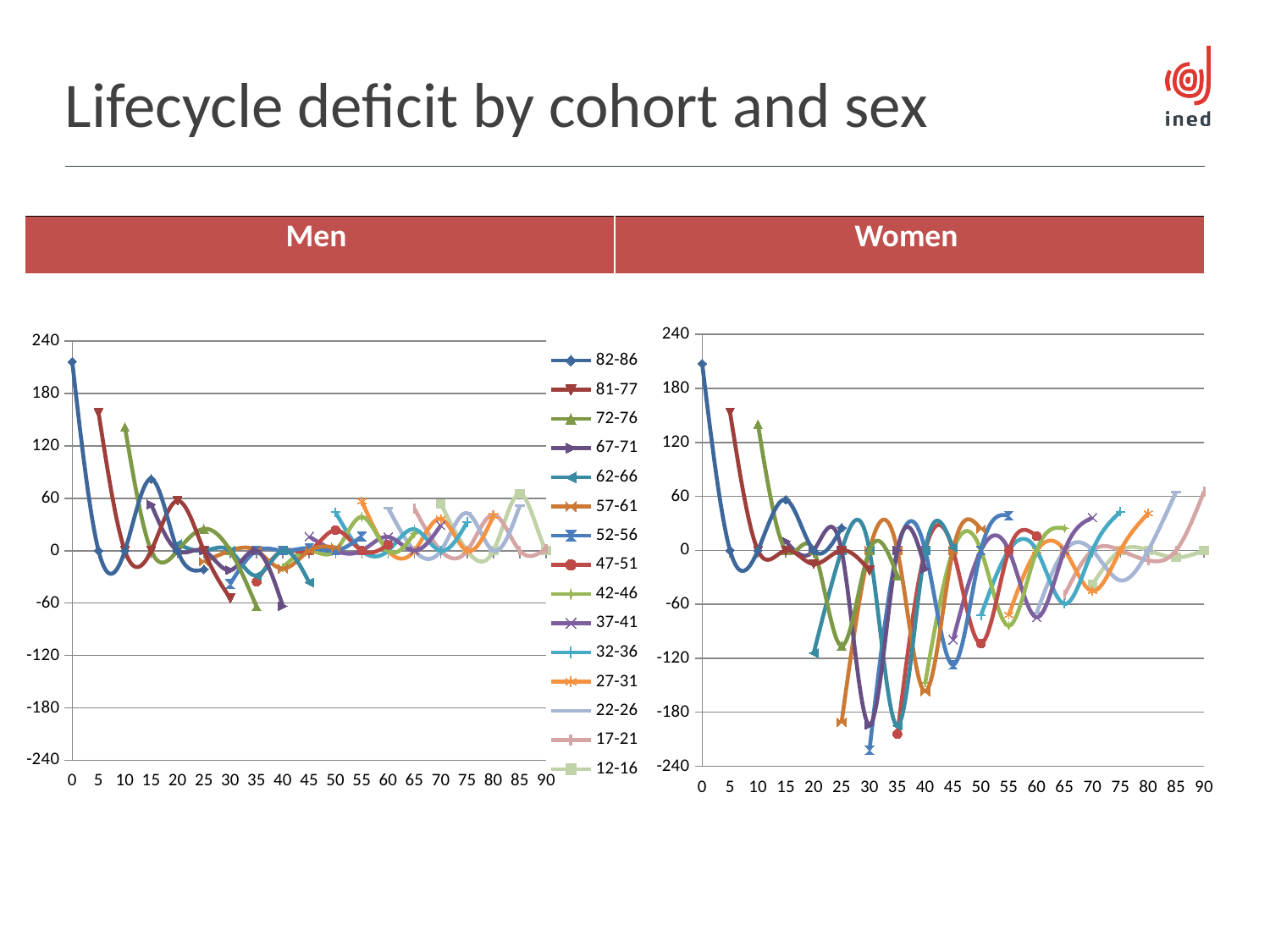
What is the first series listed in the legend of the Men chart? 82-86 On the Men chart, is the value for the 72-76 cohort at age 10 greater or less than 120? greater On the Men chart, is the value for the 82-86 cohort at age 0 greater or less than 180? greater What kind of chart is the Men chart? line chart What is the last series listed in the legend of the Men chart? 12-16 On the Women chart, is the value for the 47-51 cohort at age 35 greater or less than -180? less How many series does the legend on the Men chart list? 15 On the Men chart, which is larger: the value for the 82-86 cohort at age 0 or the value for the 81-77 cohort at age 5? 82-86 at age 0